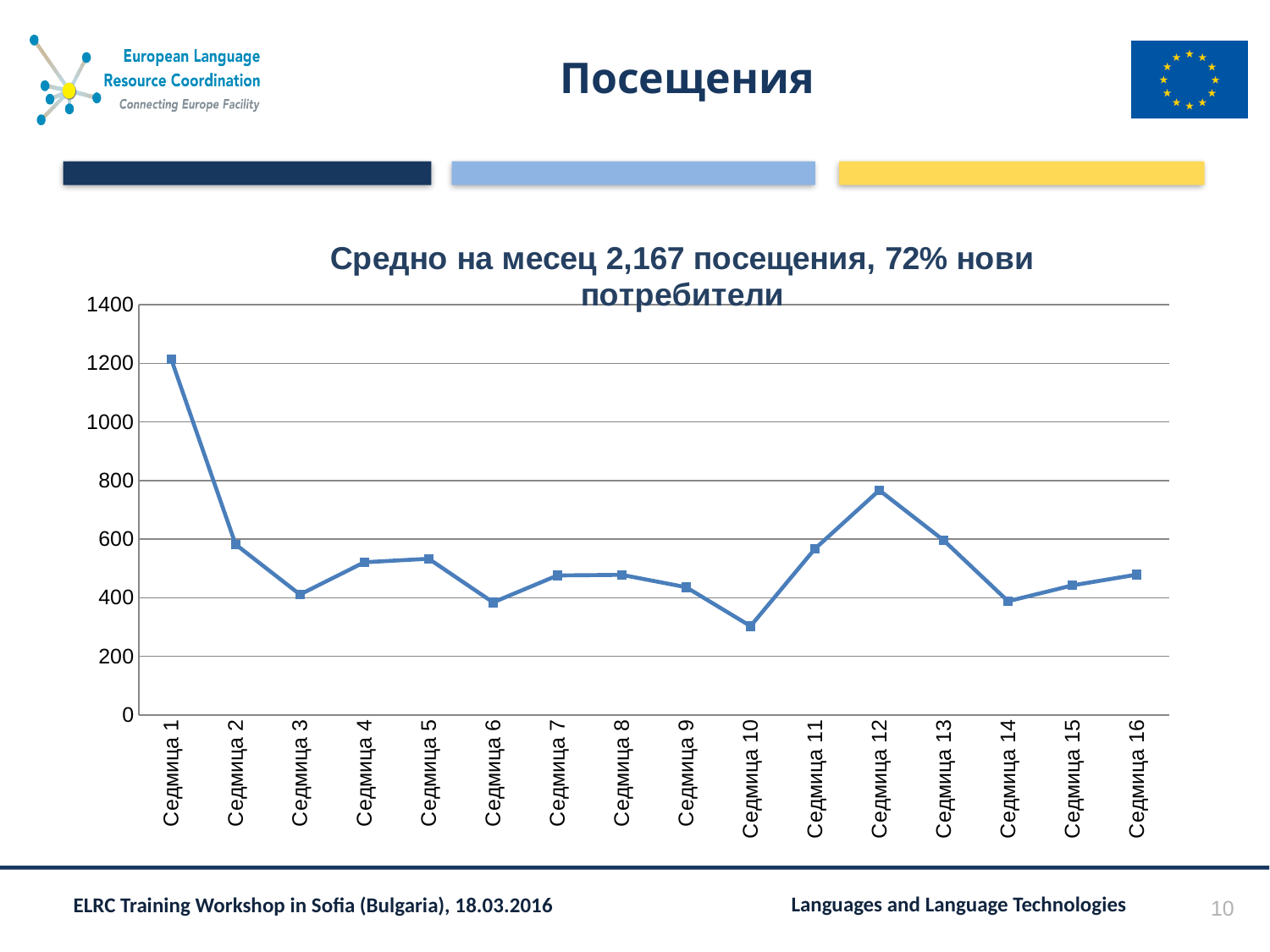
Which week has the lowest number of visits? Седмица 10 Which week has the highest number of visits? Седмица 1 Do the values rise or fall from Седмица 1 to Седмица 3? fall How many weeks (categories) are plotted along the x axis? 16 Which has more visits, Седмица 2 or Седмица 3? Седмица 2 Which has more visits, Седмица 12 or Седмица 13? Седмица 12 Is the value for Седмица 12 greater or less than 600? greater Is the value for Седмица 10 greater or less than 400? less What kind of chart is shown on the slide? line chart According to the chart title, what is the average number of visits per month? 2,167